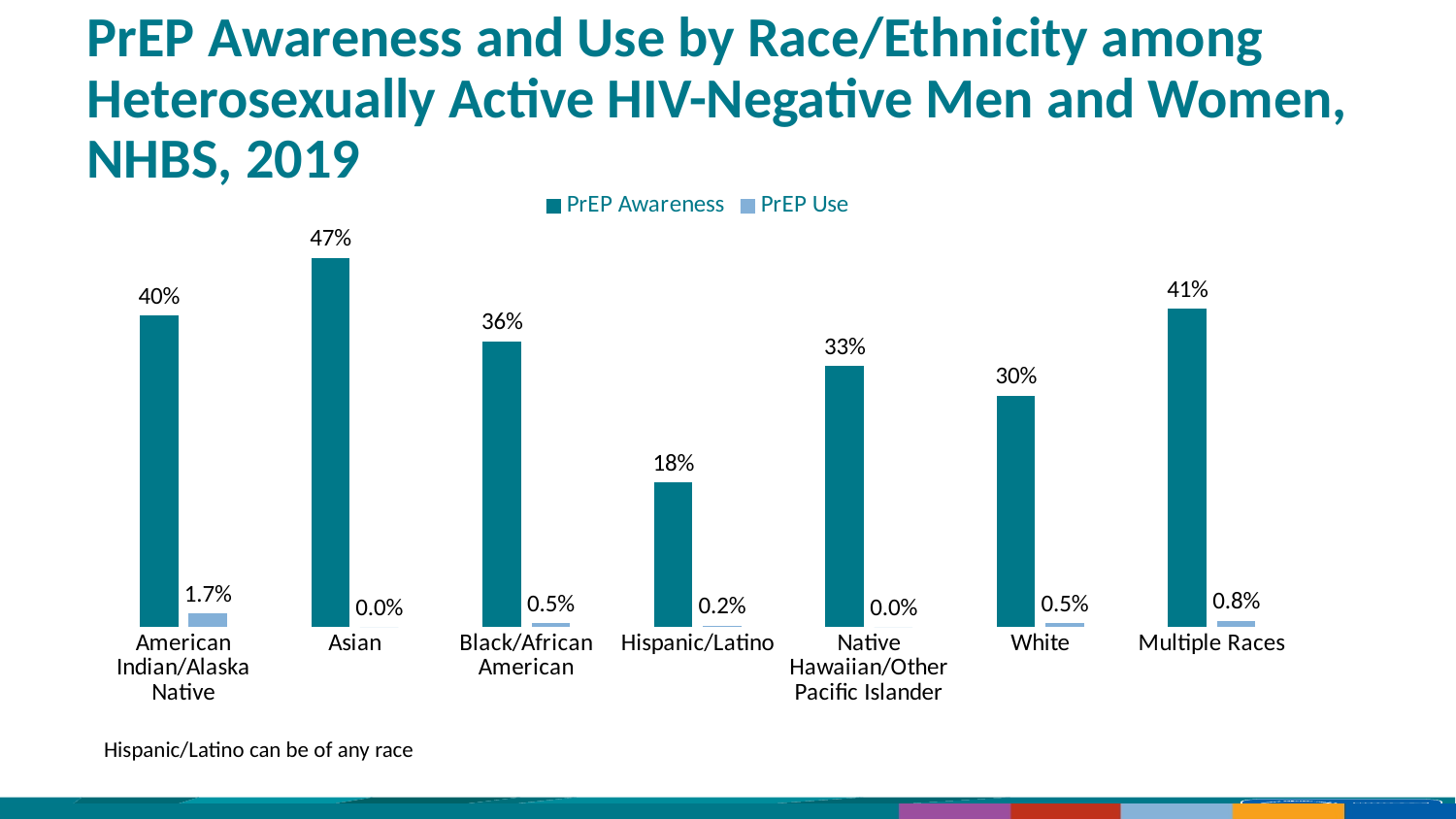
Which race/ethnicity has the highest PrEP Use? American Indian/Alaska Native What is the PrEP Awareness value for Asian? 47% Which has higher PrEP Awareness, Black/African American or Multiple Races? Multiple Races How many series does the legend list? 2 How many race/ethnicity categories are shown on the chart? 7 What kind of chart is shown on the slide? Bar chart What is the PrEP Use value for American Indian/Alaska Native? 1.7% Which race/ethnicity has the lowest PrEP Awareness? Hispanic/Latino What is the PrEP Use value for Native Hawaiian/Other Pacific Islander? 0.0% What is the PrEP Awareness value for Hispanic/Latino? 18% Which race/ethnicity has the highest PrEP Awareness? Asian What is the difference in PrEP Awareness between Asian and White? 17%